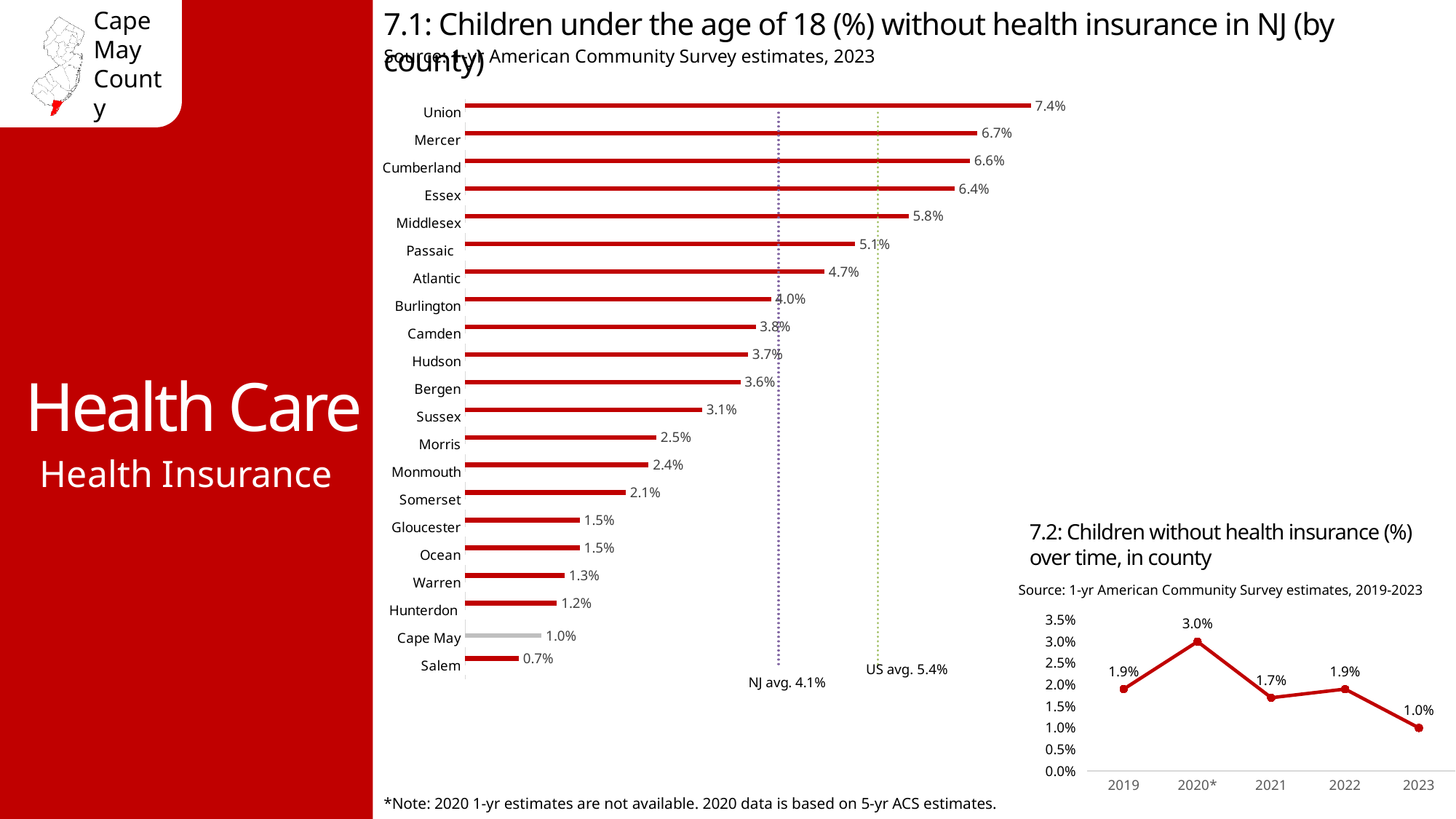
In chart 7.2, what is the difference between the 2020* value and the 2023 value? 2.0% In chart 7.1, which county has the highest percentage of children without health insurance? Union In chart 7.1, what is the value for Mercer? 6.7% In chart 7.1, how many counties are shown? 21 In chart 7.1, which county has the lowest percentage of children without health insurance? Salem In chart 7.1 (children under 18 without health insurance by county), what is the value for Cape May? 1.0% In chart 7.1, what is the difference between Union and Cape May? 6.4% In chart 7.1, what is the NJ average shown by the dotted reference line? 4.1% What type of chart is chart 7.2 (children without health insurance over time, in county)? Line chart In chart 7.1, which is larger, the value for Essex or the value for Middlesex? Essex In chart 7.2, what is the value for 2020*? 3.0% In chart 7.2, which year has the lowest value? 2023